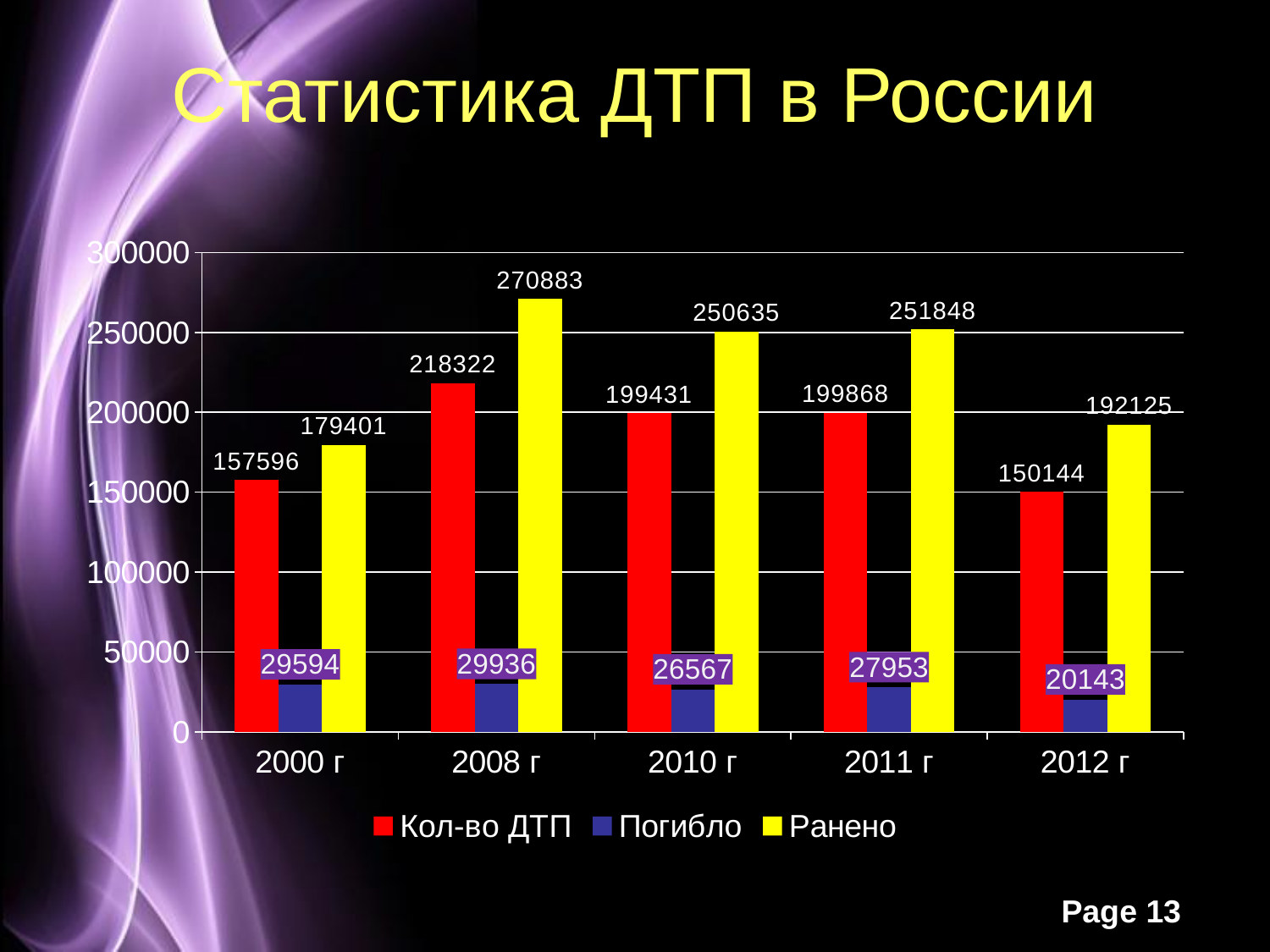
What kind of chart is shown on the slide? bar chart Is the Кол-во ДТП value for 2008 г greater or less than 200000? greater In which year is the Погибло value lowest? 2012 г What is the value of Ранено for 2012 г? 192125 What is the value of Кол-во ДТП for 2008 г? 218322 Which is larger: Кол-во ДТП for 2000 г or Кол-во ДТП for 2012 г? 2000 г How many series does the legend list? 3 In which year is the Ранено value highest? 2008 г How many years are shown on the x axis? 5 What is the title of the slide? Статистика ДТП в России What is the difference between the Ранено values for 2011 г and 2010 г? 1213 What is the value of Погибло for 2010 г? 26567